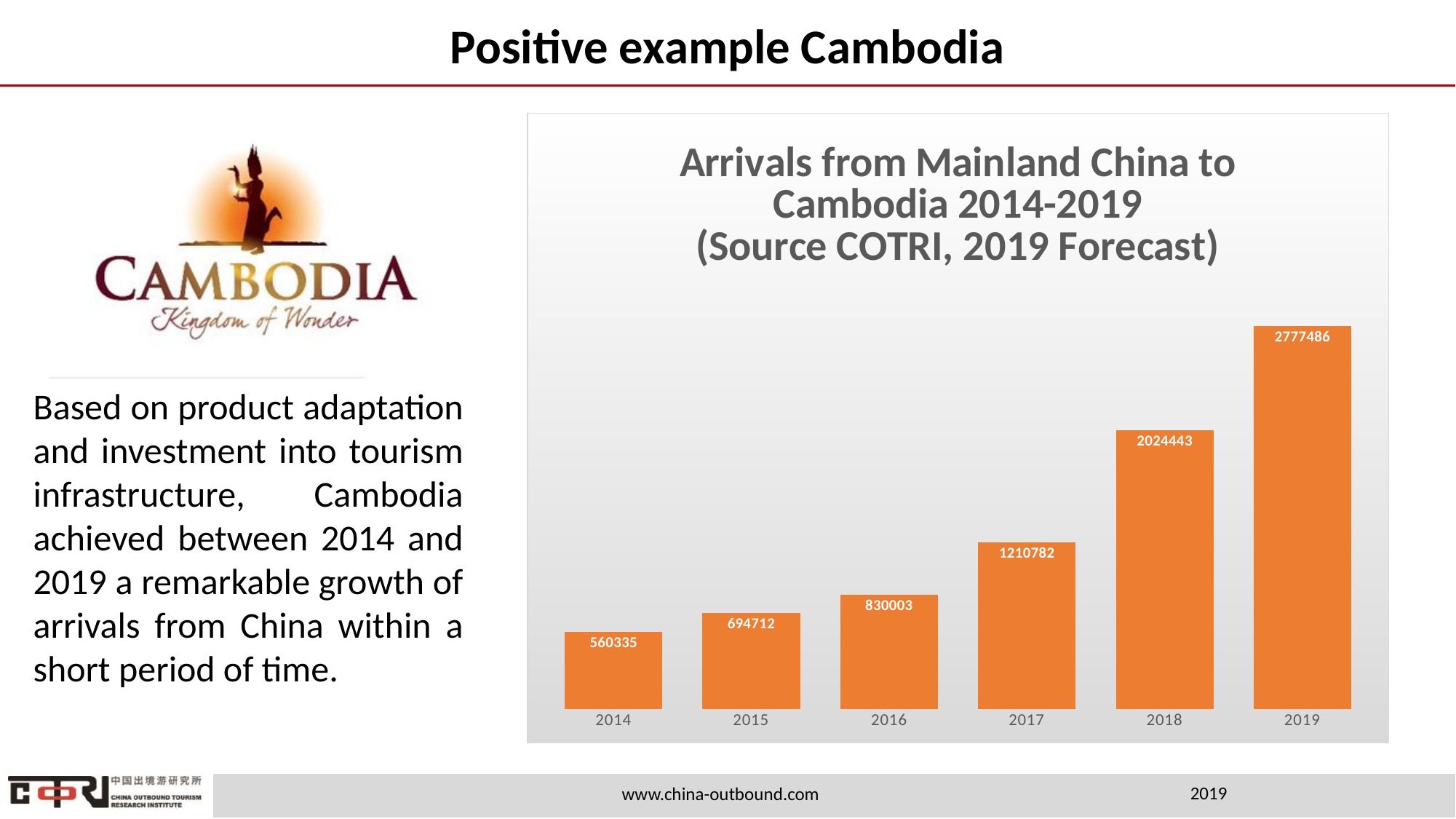
What is the difference between the values for 2015 and 2014? 134377 Do the values rise or fall from 2014 to 2019? rise What is the difference between the values for 2019 and 2018? 753043 What kind of chart is shown on the slide? bar chart Which year has the highest value in the chart? 2019 Which year has the lowest value in the chart? 2014 How many years are shown on the x axis of the chart? 6 Which is larger, the value for 2016 or the value for 2017? 2017 What is the value for 2019 in the chart? 2777486 What is the value for 2017 in the chart? 1210782 What is the value for 2014 in the chart? 560335 What is the title of the chart? Arrivals from Mainland China to Cambodia 2014-2019 (Source COTRI, 2019 Forecast)